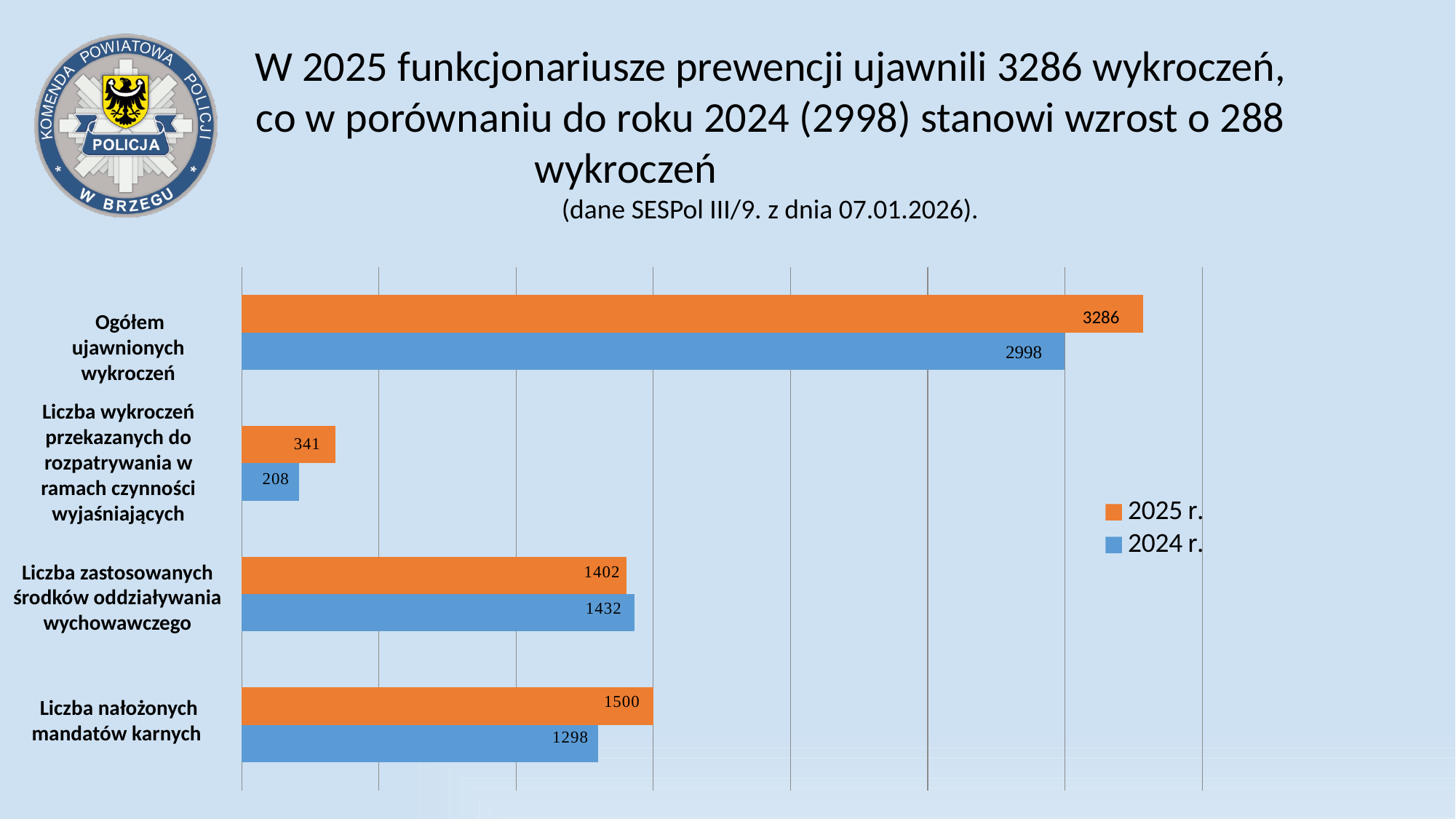
What is the value for 'Ogółem ujawnionych wykroczeń' in the 2025 r. series? 3286 What is the 2025 r. value for 'Liczba wykroczeń przekazanych do rozpatrywania w ramach czynności wyjaśniających'? 341 How many categories are shown on the chart? 4 What is the 2024 r. value for 'Liczba nałożonych mandatów karnych'? 1298 What kind of chart is shown on the slide? Bar chart Which category has the lowest value in the 2024 r. series? Liczba wykroczeń przekazanych do rozpatrywania w ramach czynności wyjaśniających What is the difference between the 2025 r. and 2024 r. values for 'Liczba nałożonych mandatów karnych'? 202 Which category has the highest value in the 2025 r. series? Ogółem ujawnionych wykroczeń What is the difference between the 2025 r. and 2024 r. values for 'Ogółem ujawnionych wykroczeń'? 288 What is the value for 'Ogółem ujawnionych wykroczeń' in the 2024 r. series? 2998 For 'Liczba zastosowanych środków oddziaływania wychowawczego', which series has the larger value, 2025 r. or 2024 r.? 2024 r. How many series does the legend list? 2